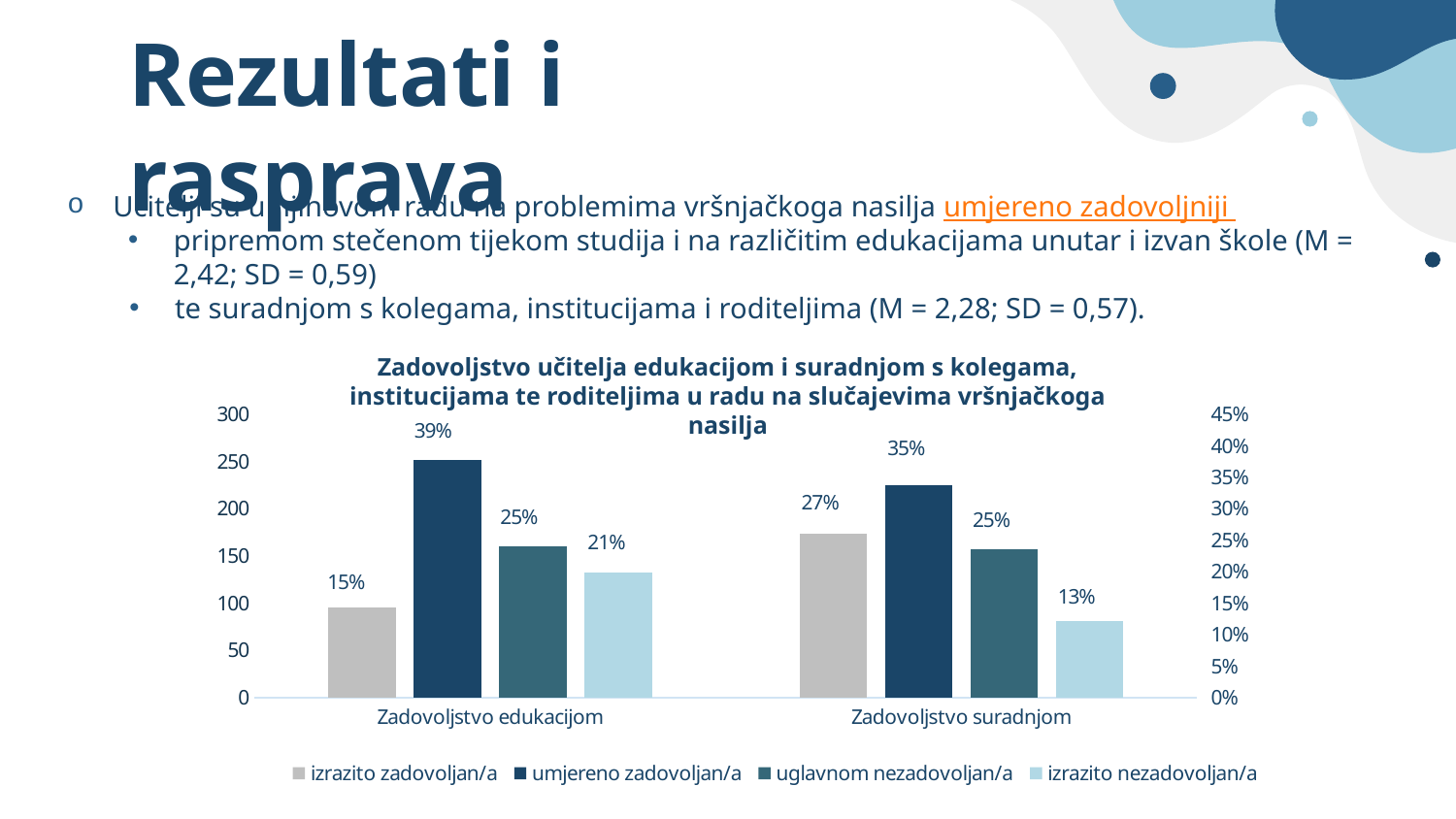
What is the value for "izrazito nezadovoljan/a" in the "Zadovoljstvo suradnjom" category? 13% Which series has the lowest value in the "Zadovoljstvo suradnjom" category? izrazito nezadovoljan/a What is the value for "umjereno zadovoljan/a" in the "Zadovoljstvo edukacijom" category? 39% What colour are the bars for the "umjereno zadovoljan/a" series? dark blue How many series does the legend list? 4 What is the value for "izrazito zadovoljan/a" in the "Zadovoljstvo suradnjom" category? 27% Which is larger: the "izrazito zadovoljan/a" value for "Zadovoljstvo edukacijom" or for "Zadovoljstvo suradnjom"? Zadovoljstvo suradnjom What kind of chart is shown on the slide? bar chart What is the difference between the "umjereno zadovoljan/a" values for "Zadovoljstvo edukacijom" and "Zadovoljstvo suradnjom"? 4% Which series has the highest value in the "Zadovoljstvo edukacijom" category? umjereno zadovoljan/a What is the difference between the "izrazito nezadovoljan/a" values for "Zadovoljstvo edukacijom" and "Zadovoljstvo suradnjom"? 8% How many categories are shown on the x axis? 2